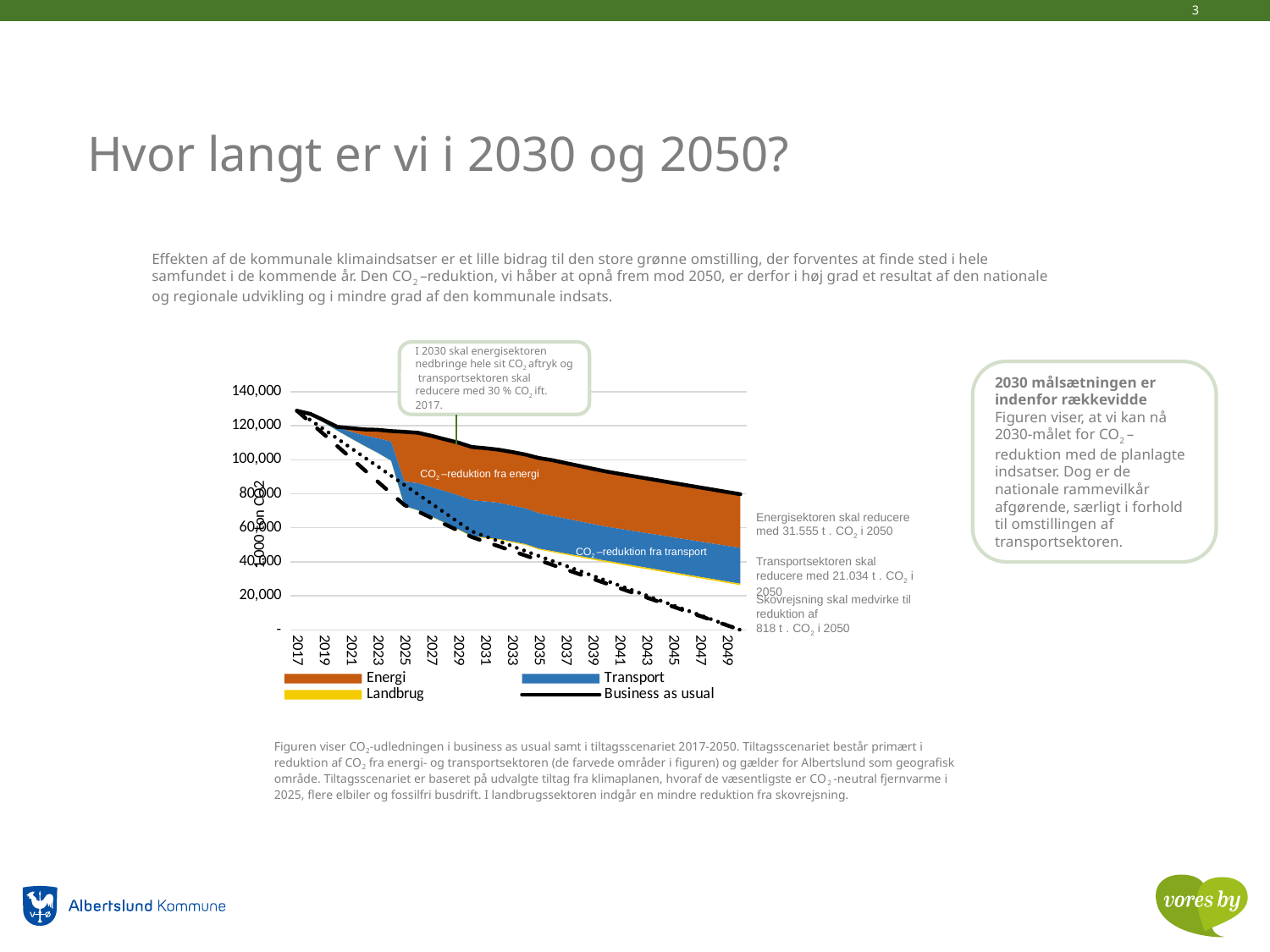
According to the annotation next to the chart, by how much should the energy sector reduce CO2 in 2050? 31.555 t. CO2 Is the Business as usual value in 2049 greater or less than 20,000? greater According to the annotation next to the chart, how much reduction should afforestation (skovrejsning) contribute in 2050? 818 t. CO2 Which series are listed in the chart legend? Energi, Transport, Landbrug, Business as usual Does the Business as usual line rise or fall from 2017 to 2049? fall According to the annotation next to the chart, by how much should the transport sector reduce CO2 in 2050? 21.034 t. CO2 What is the first year labelled on the horizontal axis of the chart? 2017 How many series does the chart legend list? 4 What kind of chart is shown on the slide? combination area and line chart Is the Business as usual value in 2017 greater or less than 120,000? greater What is the highest value shown on the vertical axis of the chart? 140,000